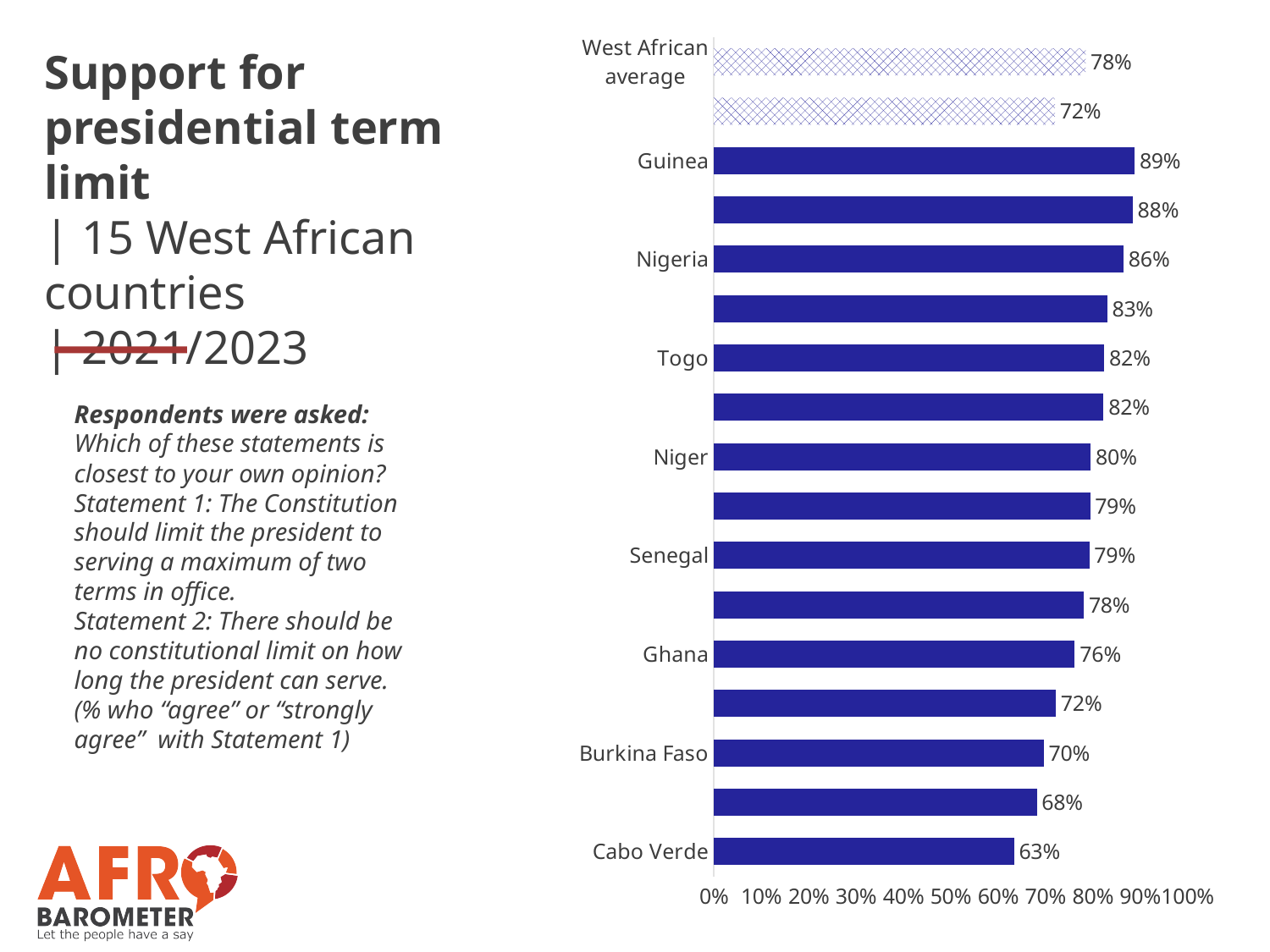
Which country has the lowest value? Cabo Verde Which country has the highest value? Guinea What kind of chart is shown on the slide? Bar chart How many West African countries does the slide title say are covered? 15 Which is larger, the value for Togo or the value for Niger? Togo What is the difference between the values for Guinea and Cabo Verde? 26 percentage points What is the value for Burkina Faso? 70% What is the value for Nigeria? 86% What is the value shown for the first West African average bar? 78% What is the value for Guinea? 89% What is the value for Cabo Verde? 63% What is the difference between the values for Nigeria and Ghana? 10 percentage points